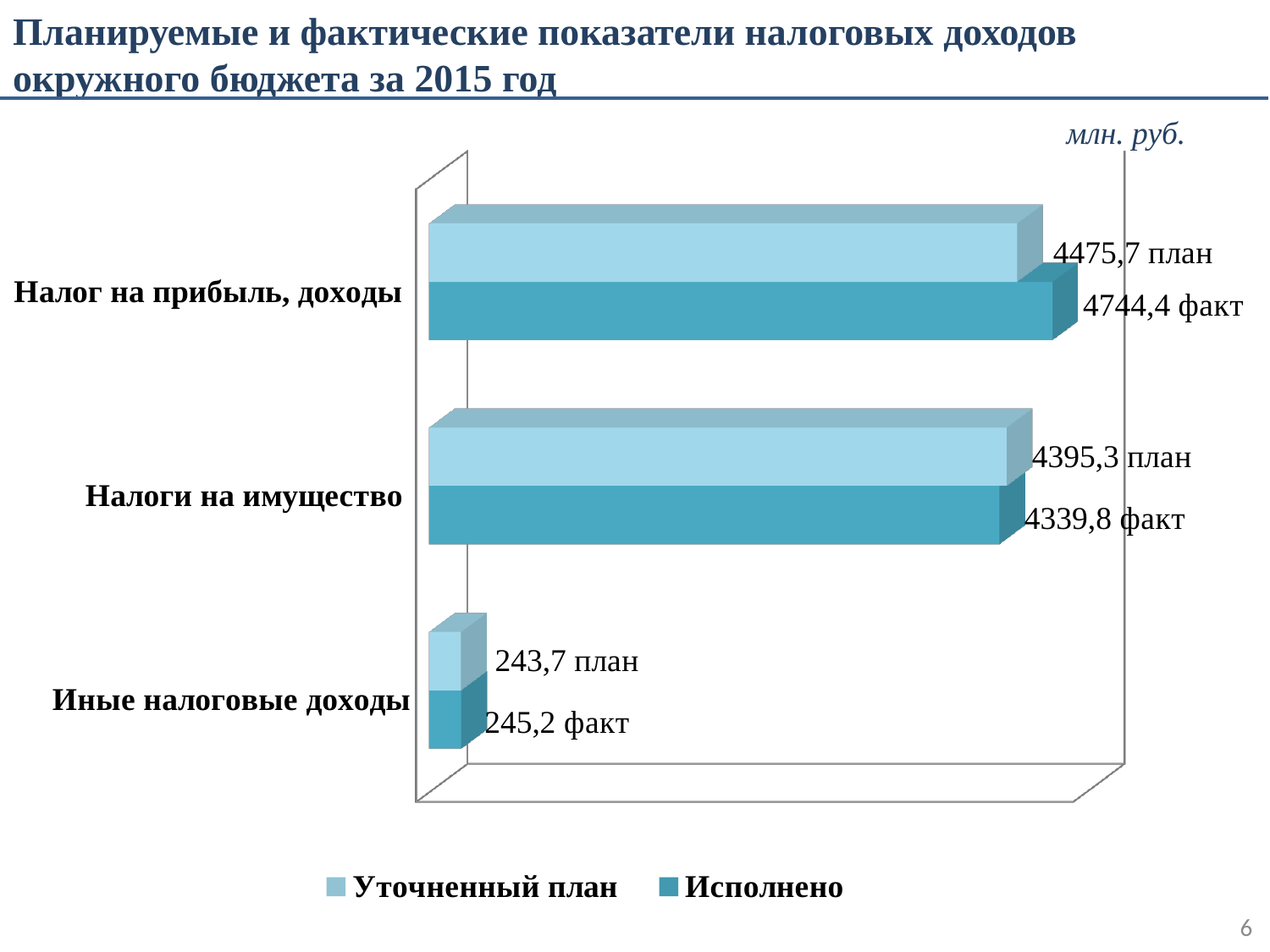
What is the planned value (Уточненный план) for Налог на прибыль, доходы? 4475,7 What is the difference between the planned and executed values for Налоги на имущество? 55,5 Which category has the highest executed (Исполнено) value? Налог на прибыль, доходы How many series does the legend list? 2 What is the executed value (Исполнено) for Налог на прибыль, доходы? 4744,4 What type of chart is shown on the slide? bar chart Which category has the lowest planned (Уточненный план) value? Иные налоговые доходы By how much does the executed value exceed the planned value for Налог на прибыль, доходы? 268,7 How many categories are shown on the chart? 3 For Налоги на имущество, which is larger: the planned value or the executed value? the planned value (4395,3) What is the planned value (Уточненный план) for Налоги на имущество? 4395,3 What is the executed value (Исполнено) for Иные налоговые доходы? 245,2